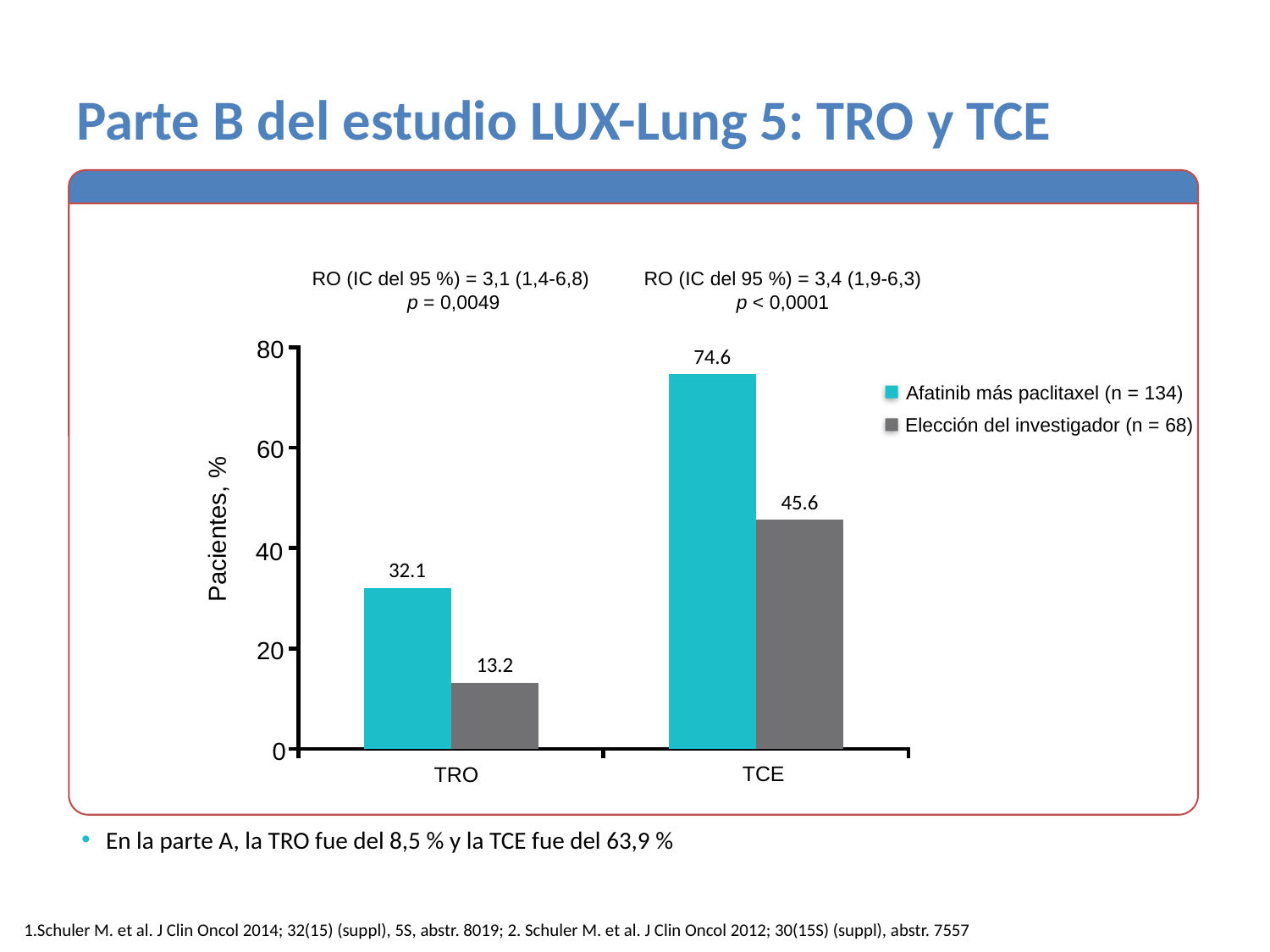
Which is larger in the TRO category: Afatinib más paclitaxel or Elección del investigador? Afatinib más paclitaxel What is the value for Afatinib más paclitaxel (n = 134) in the TCE category? 74.6 How many series does the legend list? 2 Which bar has the lowest value on the chart? Elección del investigador (n = 68) in TRO What is the difference between the Afatinib más paclitaxel and Elección del investigador values in the TCE category? 29 What kind of chart is shown on the slide? Bar chart What is the value for Elección del investigador (n = 68) in the TCE category? 45.6 What is the value for Elección del investigador (n = 68) in the TRO category? 13.2 What is the value for Afatinib más paclitaxel (n = 134) in the TRO category? 32.1 What is the label of the y axis? Pacientes, % Which bar has the highest value on the chart? Afatinib más paclitaxel (n = 134) in TCE What is the difference between the Afatinib más paclitaxel and Elección del investigador values in the TRO category? 18.9